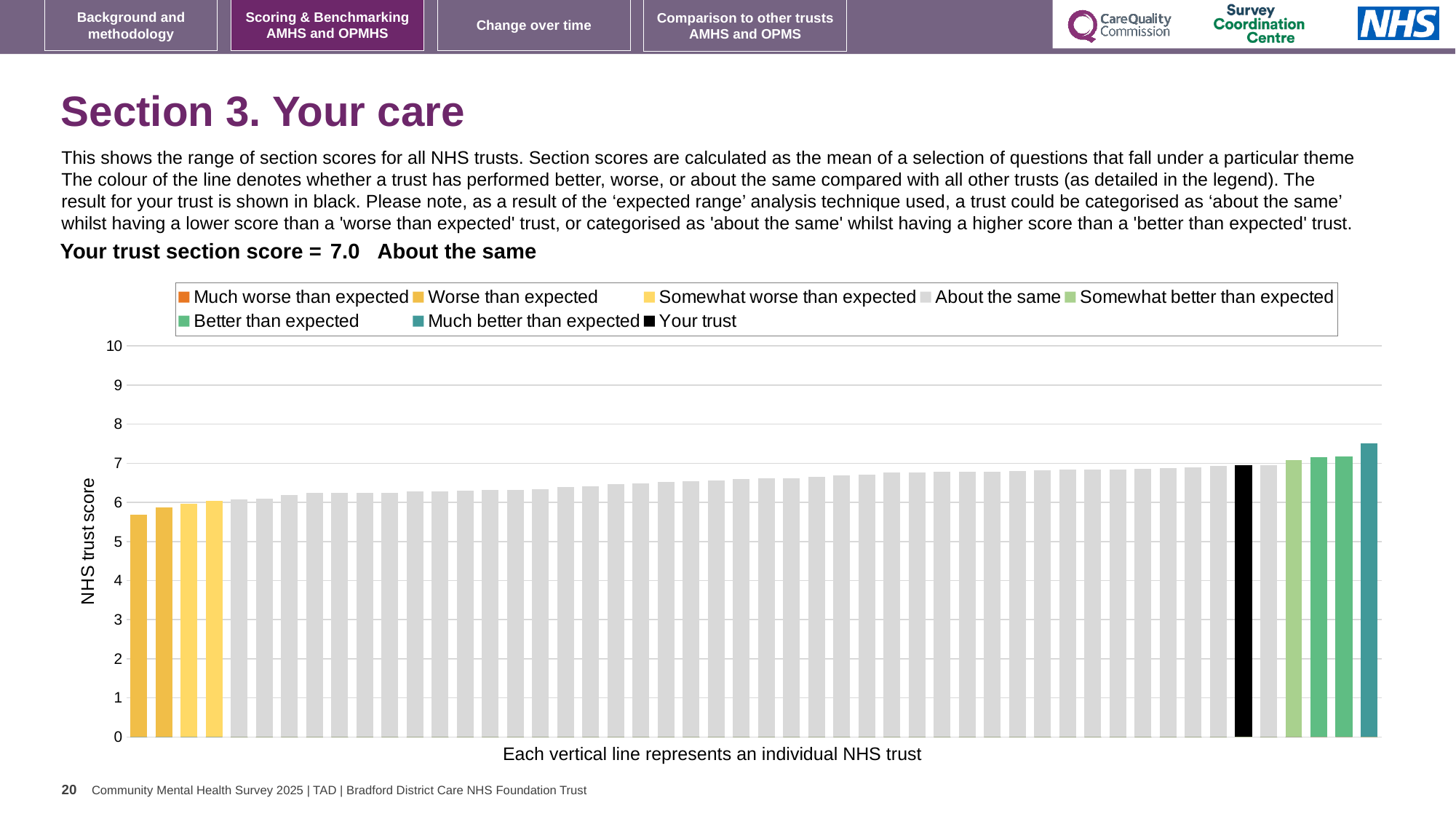
How many entries does the chart legend list? 8 Is the value of the lowest bar greater or less than 6? less Do the bar values rise or fall from left to right along the x axis? Rise Which category is your trust's section score placed in? About the same Is your trust's section score greater or less than 5? greater What is the section score for your trust shown on the slide? 7.0 Which legend category does the tallest (rightmost) bar belong to? Much better than expected What is the highest value shown on the vertical axis? 10 Is the value of the highest bar greater or less than 7? greater What colour is the bar representing your trust? Black What kind of chart is shown on the slide? Bar chart What is the label on the vertical axis of the chart? NHS trust score